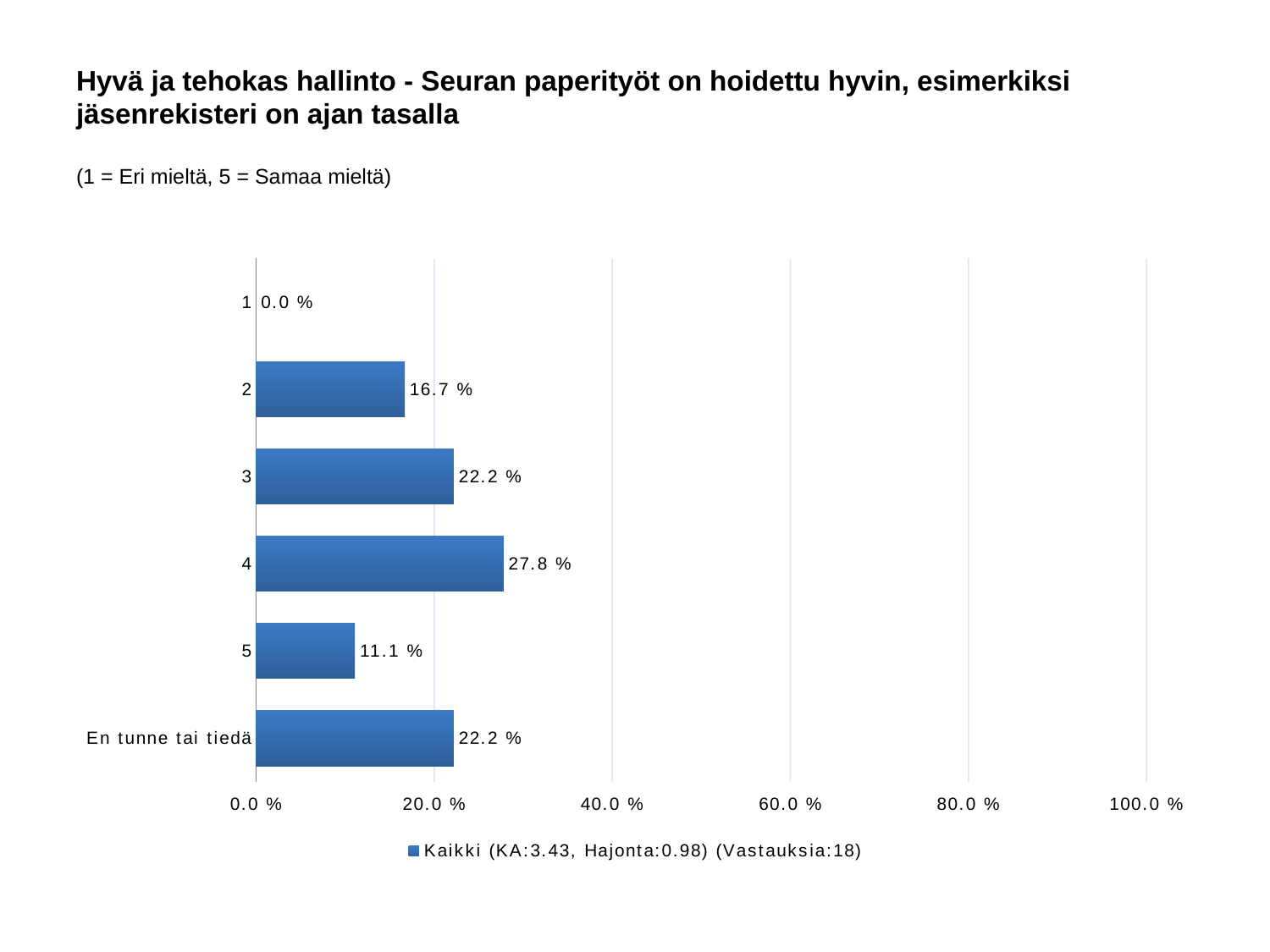
What is the value for category 4? 27.8 % How many responses (Vastauksia) does the legend report? 18 Which category has the lowest value? 1 Is the value for category 4 greater or less than 20.0 %? greater What is the difference between the values for category 4 and category 5? 16.7 % Which is larger, the value for category 2 or the value for category 5? 2 What kind of chart is shown on the slide? bar chart How many categories are shown on the chart? 6 What is the value for category 1? 0.0 % What is the value for "En tunne tai tiedä"? 22.2 % What is the value for category 2? 16.7 % Which category has the highest value? 4